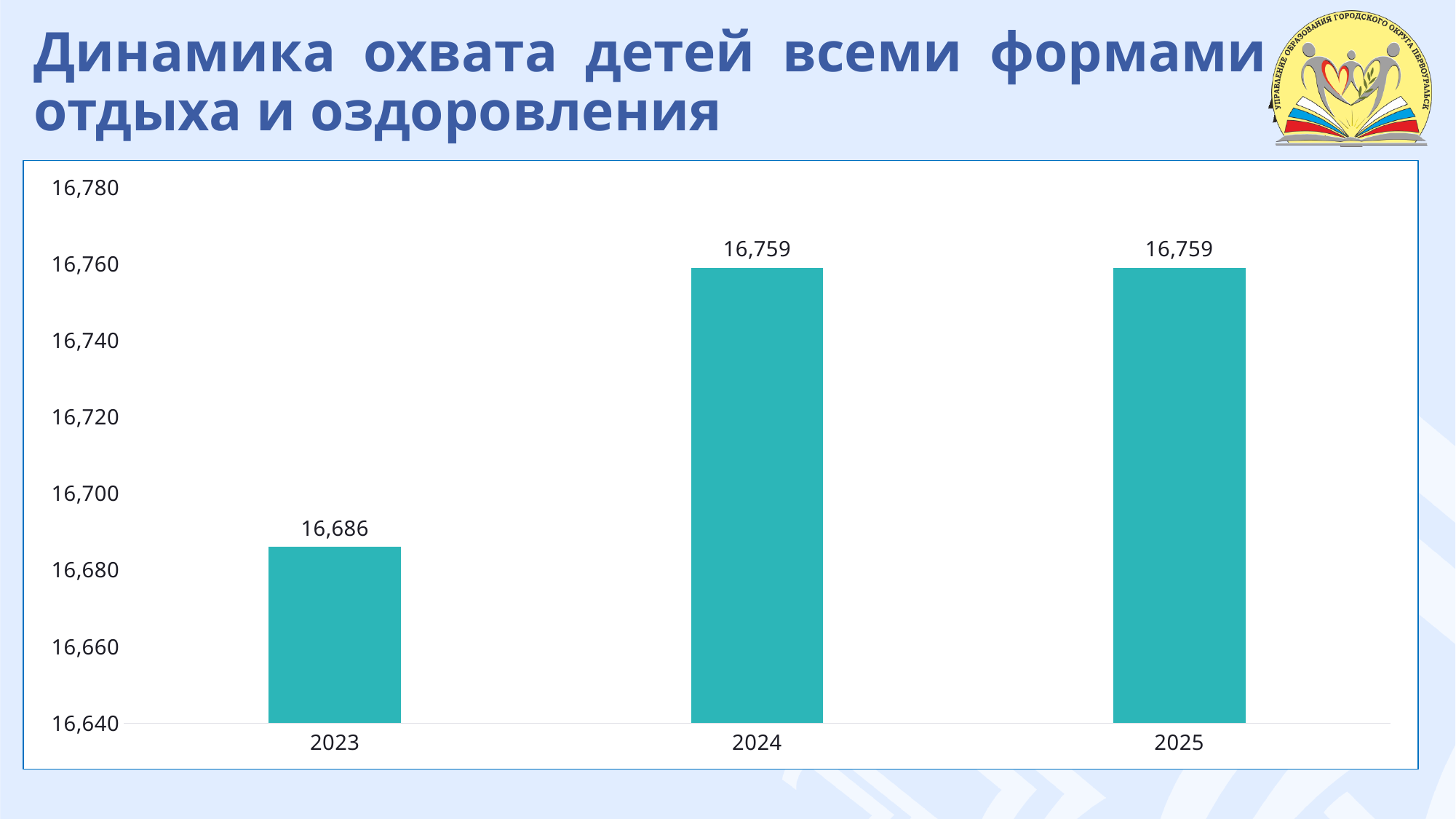
Is the value for 2023 greater or less than 16,700? less How many years are shown on the x axis? 3 What is the value for 2024? 16,759 Which year has the lowest value? 2023 Is the value for 2025 greater or less than 16,740? greater What is the value for 2023? 16,686 Which is larger, the value for 2023 or the value for 2024? 2024 What kind of chart is shown on the slide? bar chart What is the value for 2025? 16,759 What is the difference between the values for 2024 and 2023? 73 Do the values rise or fall from 2023 to 2024? rise What is the title of the slide? Динамика охвата детей всеми формами отдыха и оздоровления